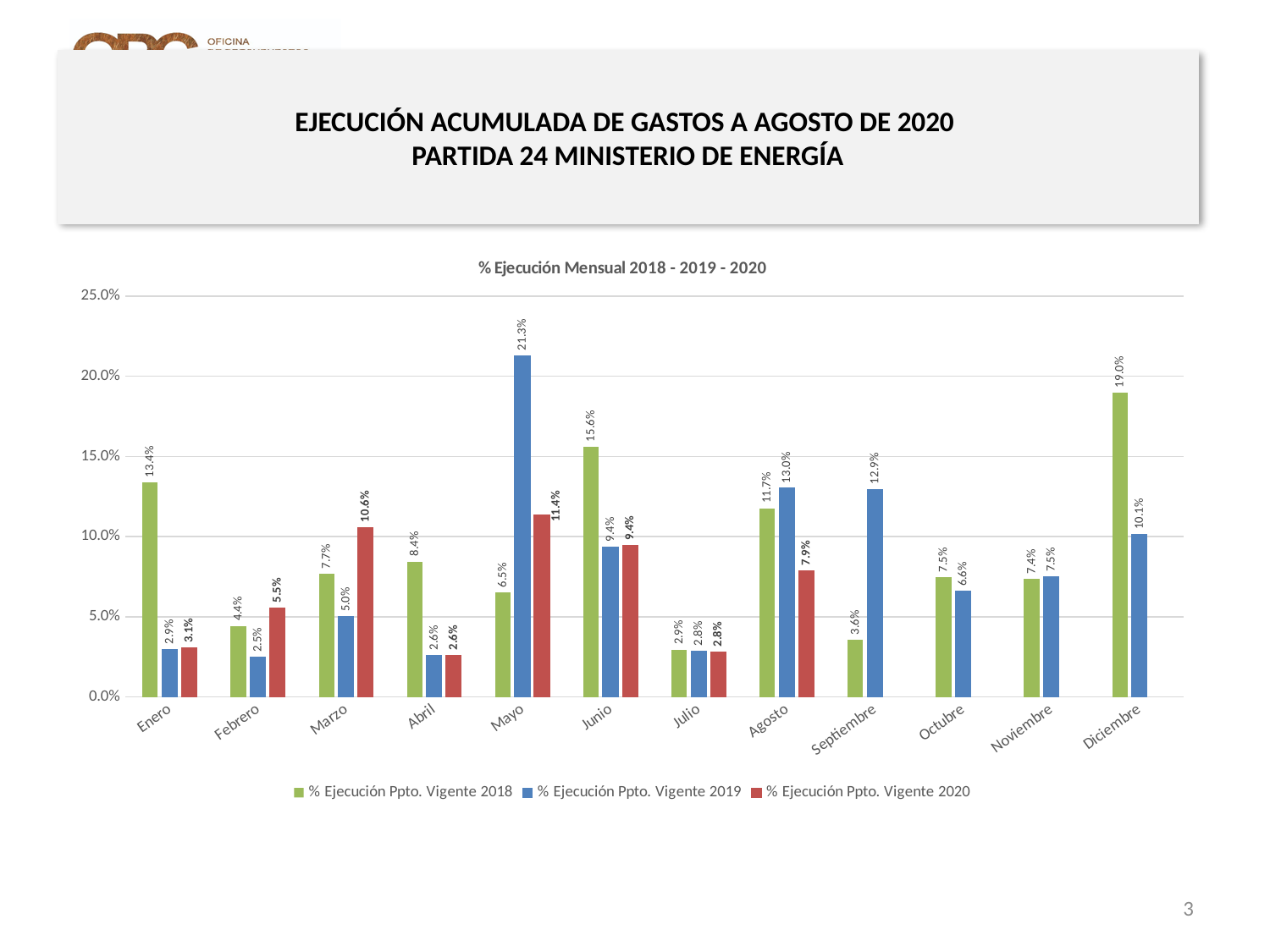
Is the value for % Ejecución Ppto. Vigente 2018 in Junio greater or less than 15.0%? greater Which month has the lowest value for % Ejecución Ppto. Vigente 2019? Febrero What kind of chart is shown on the slide? Bar chart What is the value for % Ejecución Ppto. Vigente 2018 in Diciembre? 19.0% How many months are shown on the x axis? 12 What is the title of the chart? % Ejecución Mensual 2018 - 2019 - 2020 Which month has the highest value for % Ejecución Ppto. Vigente 2018? Diciembre What is the value for % Ejecución Ppto. Vigente 2019 in Mayo? 21.3% How many series does the legend list? 3 What is the difference between the 2019 and 2018 values in Mayo? 14.8% In Agosto, which series has the larger value: % Ejecución Ppto. Vigente 2018 or % Ejecución Ppto. Vigente 2019? % Ejecución Ppto. Vigente 2019 What is the value for % Ejecución Ppto. Vigente 2020 in Marzo? 10.6%